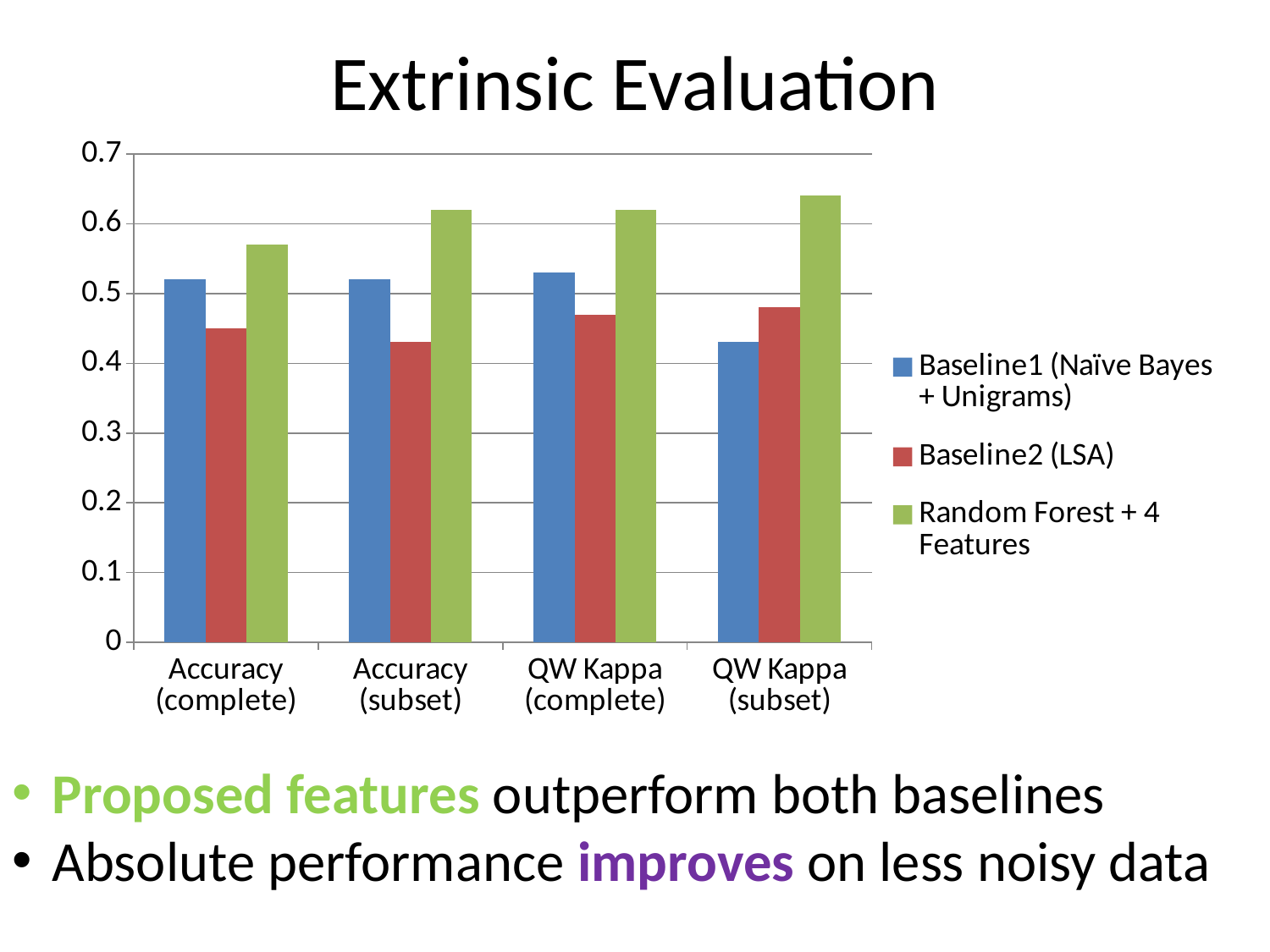
Is the value for Random Forest + 4 Features at QW Kappa (subset) greater or less than 0.6? greater How many categories are shown on the x axis of the chart? 4 For QW Kappa (subset), which is larger: Baseline1 (Naïve Bayes + Unigrams) or Baseline2 (LSA)? Baseline2 (LSA) For Accuracy (complete), which series has the highest bar? Random Forest + 4 Features What colour represents the Random Forest + 4 Features series in the chart? green Is the value for Baseline1 (Naïve Bayes + Unigrams) at Accuracy (complete) greater or less than 0.5? greater For QW Kappa (subset), which series has the lowest bar? Baseline1 (Naïve Bayes + Unigrams) How many series does the chart's legend list? 3 What is the title of the chart? Extrinsic Evaluation What kind of chart is shown on the slide? bar chart In which category does the Random Forest + 4 Features series reach its highest value? QW Kappa (subset) Is the value for Baseline2 (LSA) at Accuracy (subset) greater or less than 0.5? less